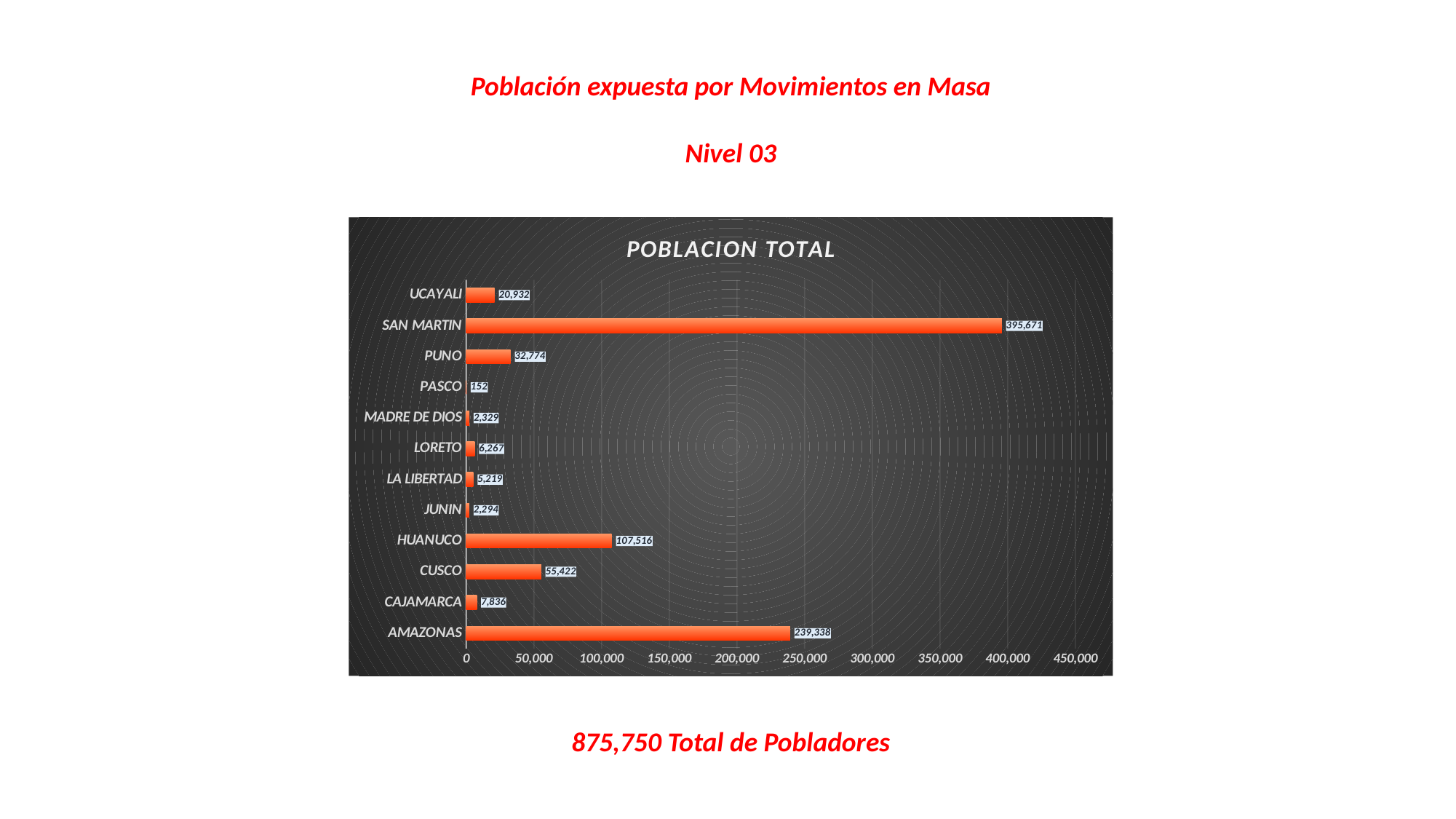
What is the value for HUANUCO? 107,516 What is the value for SAN MARTIN? 395,671 Which is larger, the value for CUSCO or the value for PUNO? CUSCO What is the difference between the values for SAN MARTIN and AMAZONAS? 156,333 Which category has the highest value? SAN MARTIN What kind of chart is shown on the slide? bar chart What is the value for PASCO? 152 Is the value for HUANUCO greater or less than 100,000? greater How many categories are shown in the chart? 12 What is the value for AMAZONAS? 239,338 What is the title of the chart? POBLACION TOTAL Which category has the lowest value? PASCO